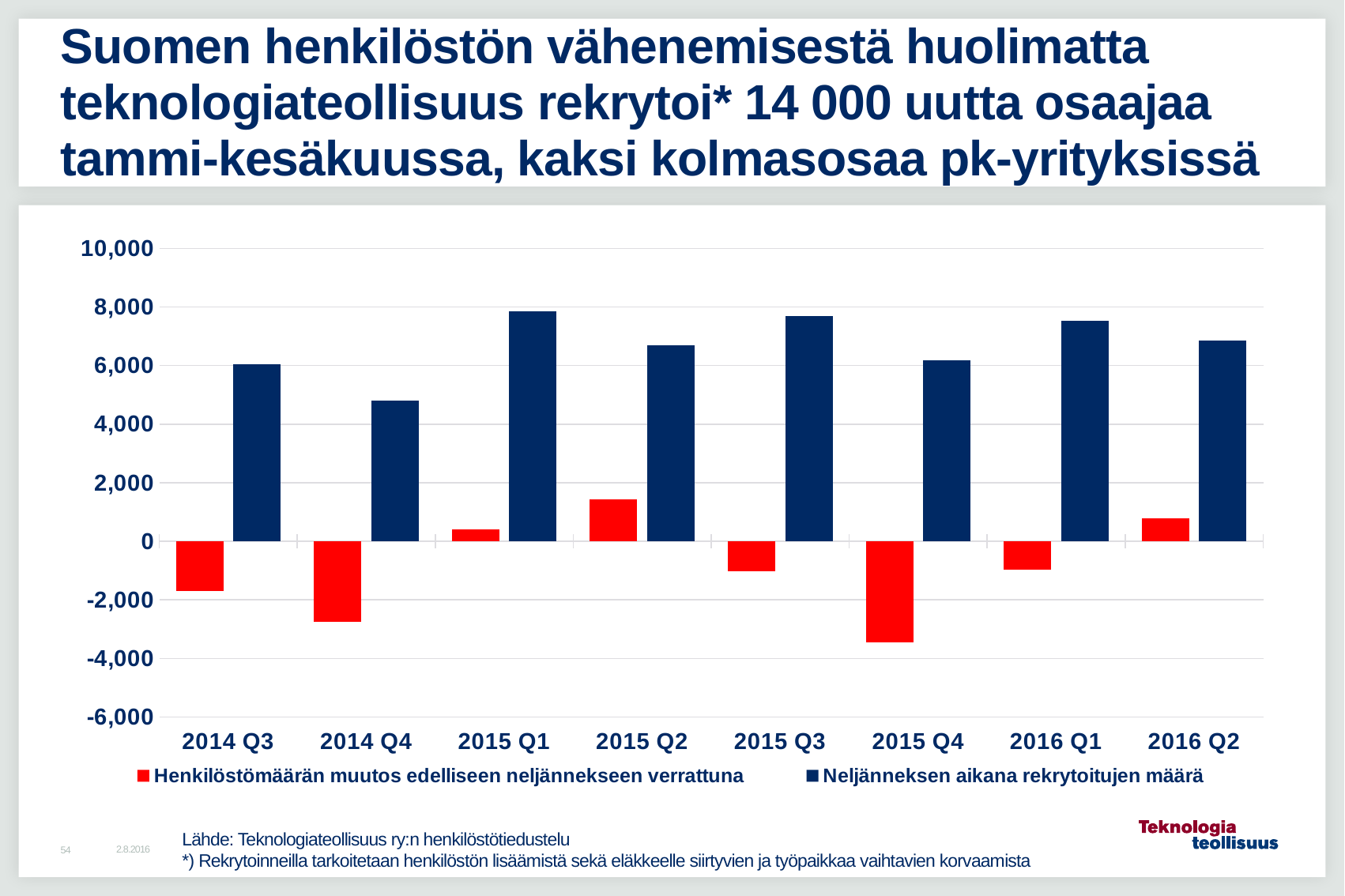
Which quarter has the highest value for 'Henkilöstömäärän muutos edelliseen neljännekseen verrattuna'? 2015 Q2 Is the value for 'Neljänneksen aikana rekrytoitujen määrä' in 2014 Q4 greater or less than 6,000? less How many series does the chart's legend list? 2 Which quarter has the lowest value for 'Henkilöstömäärän muutos edelliseen neljännekseen verrattuna'? 2015 Q4 Is the value for 'Henkilöstömäärän muutos edelliseen neljännekseen verrattuna' in 2015 Q4 greater or less than -2,000? less Is the value for 'Neljänneksen aikana rekrytoitujen määrä' in 2015 Q1 greater or less than 6,000? greater What colour are the bars for 'Neljänneksen aikana rekrytoitujen määrä'? dark blue How many quarters are shown on the x axis of the chart? 8 Which is larger, the 'Neljänneksen aikana rekrytoitujen määrä' value for 2015 Q3 or for 2015 Q4? 2015 Q3 What kind of chart is shown on the slide? bar chart Which is larger, the 'Neljänneksen aikana rekrytoitujen määrä' value for 2016 Q1 or for 2014 Q4? 2016 Q1 Which quarter has the lowest value for 'Neljänneksen aikana rekrytoitujen määrä'? 2014 Q4